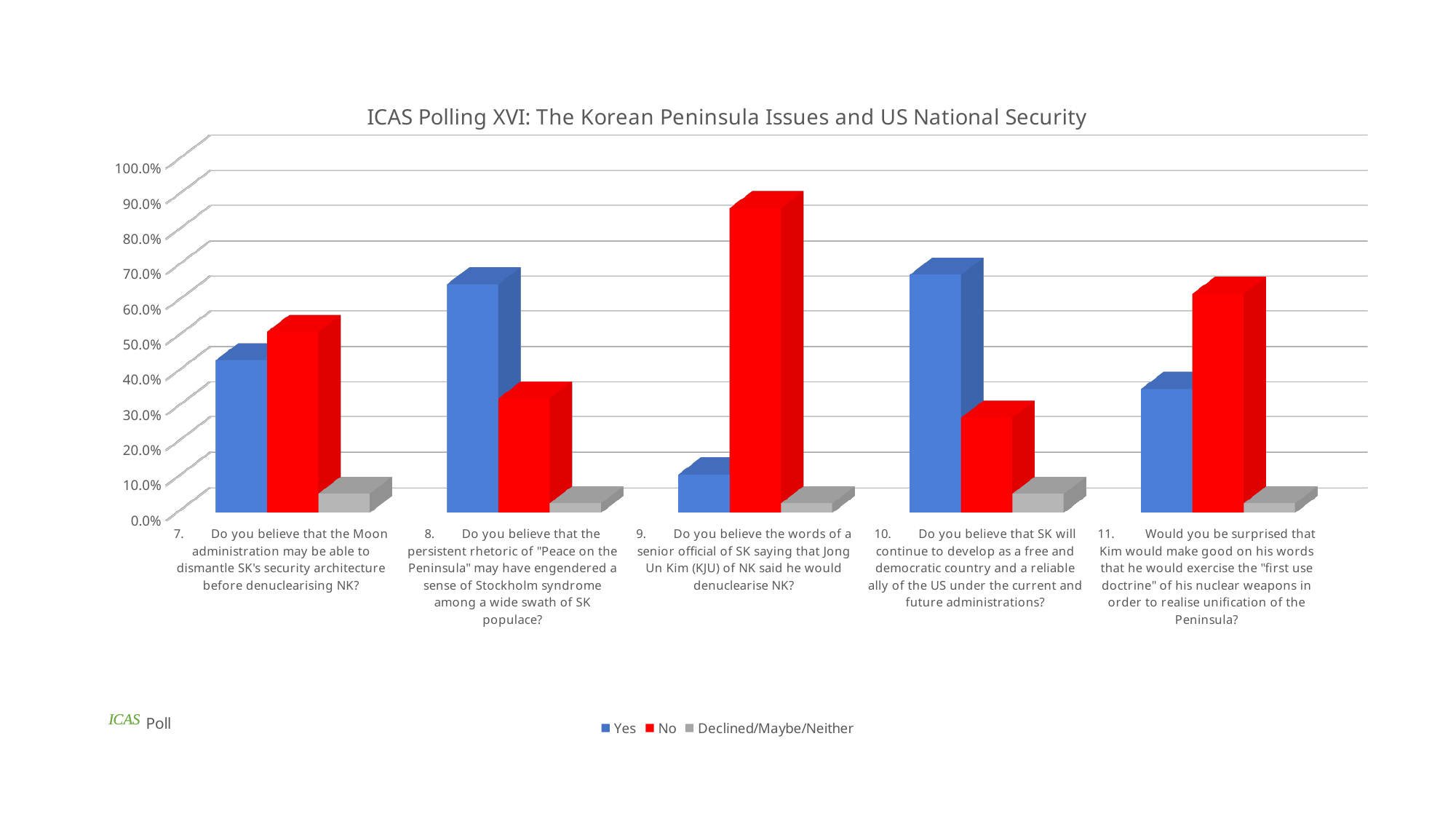
For which question is the "Yes" bar the lowest? 9. Do you believe the words of a senior official of SK saying that Jong Un Kim (KJU) of NK said he would denuclearise NK? Is the "No" value for question 9 greater or less than 80.0%? greater For which question is the "No" bar the highest? 9. Do you believe the words of a senior official of SK saying that Jong Un Kim (KJU) of NK said he would denuclearise NK? For question 10, which is larger, the "Yes" value or the "No" value? Yes Is the "Yes" value for question 11 greater or less than 40.0%? less Is the "Yes" value for question 8 greater or less than 60.0%? greater For question 7, which is larger, the "Yes" value or the "No" value? No What kind of chart is shown on the slide? Bar chart How many questions (categories) are plotted along the x axis? 5 How many series does the legend list? 3 What is the title of the chart? ICAS Polling XVI: The Korean Peninsula Issues and US National Security